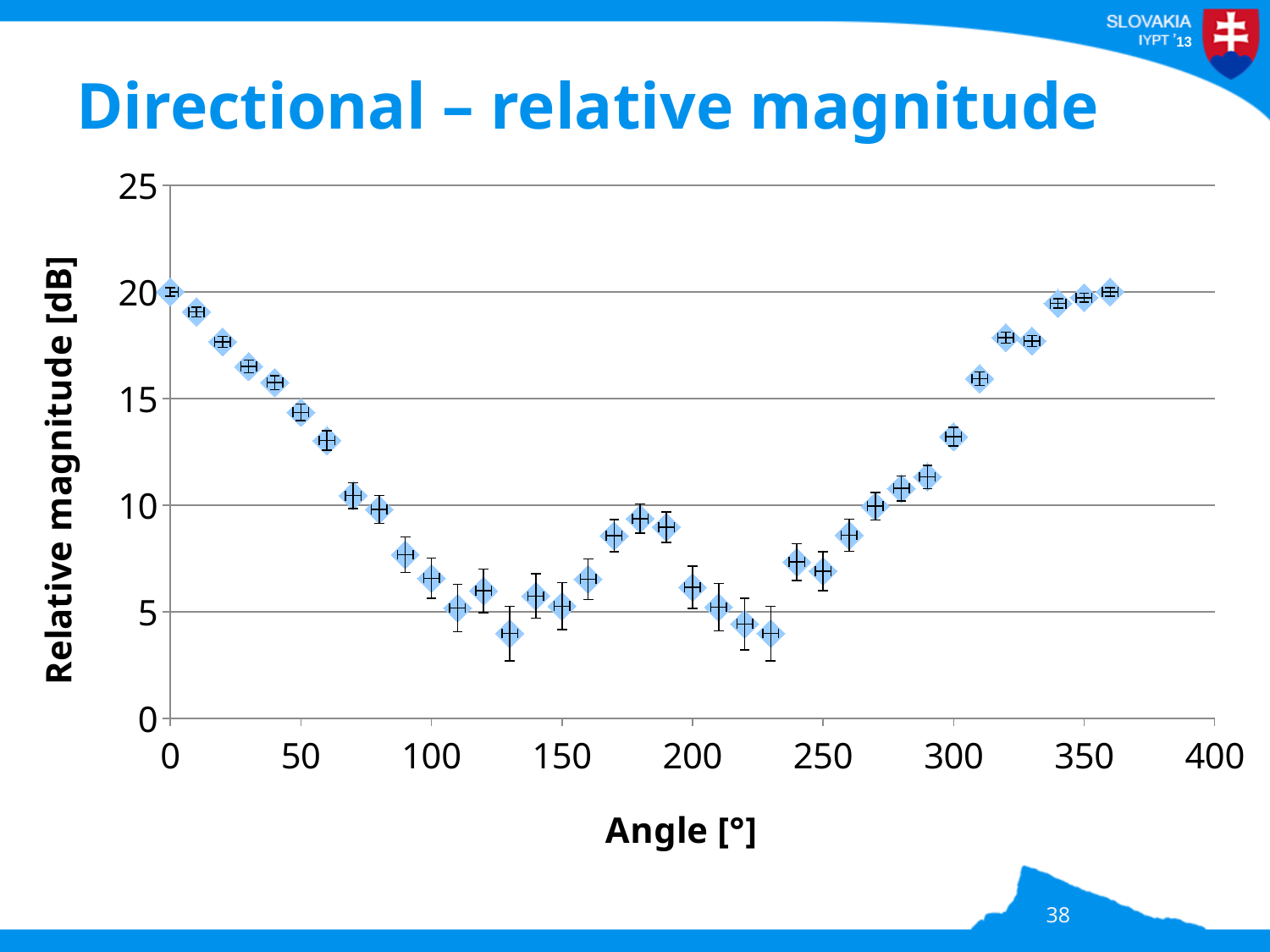
Is the relative magnitude at an angle of 0° greater or less than 15 dB? greater Do the values rise or fall as the angle increases from 0° to 130°? fall Which has the larger relative magnitude: the point at 0° or the point at 180°? 0° Is the relative magnitude at an angle of 130° greater or less than 5 dB? less Is the relative magnitude at an angle of 100° greater or less than 5 dB? greater What is the label of the y axis? Relative magnitude [dB] Do the values rise or fall as the angle increases from 230° to 360°? rise Which has the larger relative magnitude: the point at 60° or the point at 120°? 60° What is the title of the chart on the slide? Directional – relative magnitude What kind of chart is shown on the slide? scatter chart